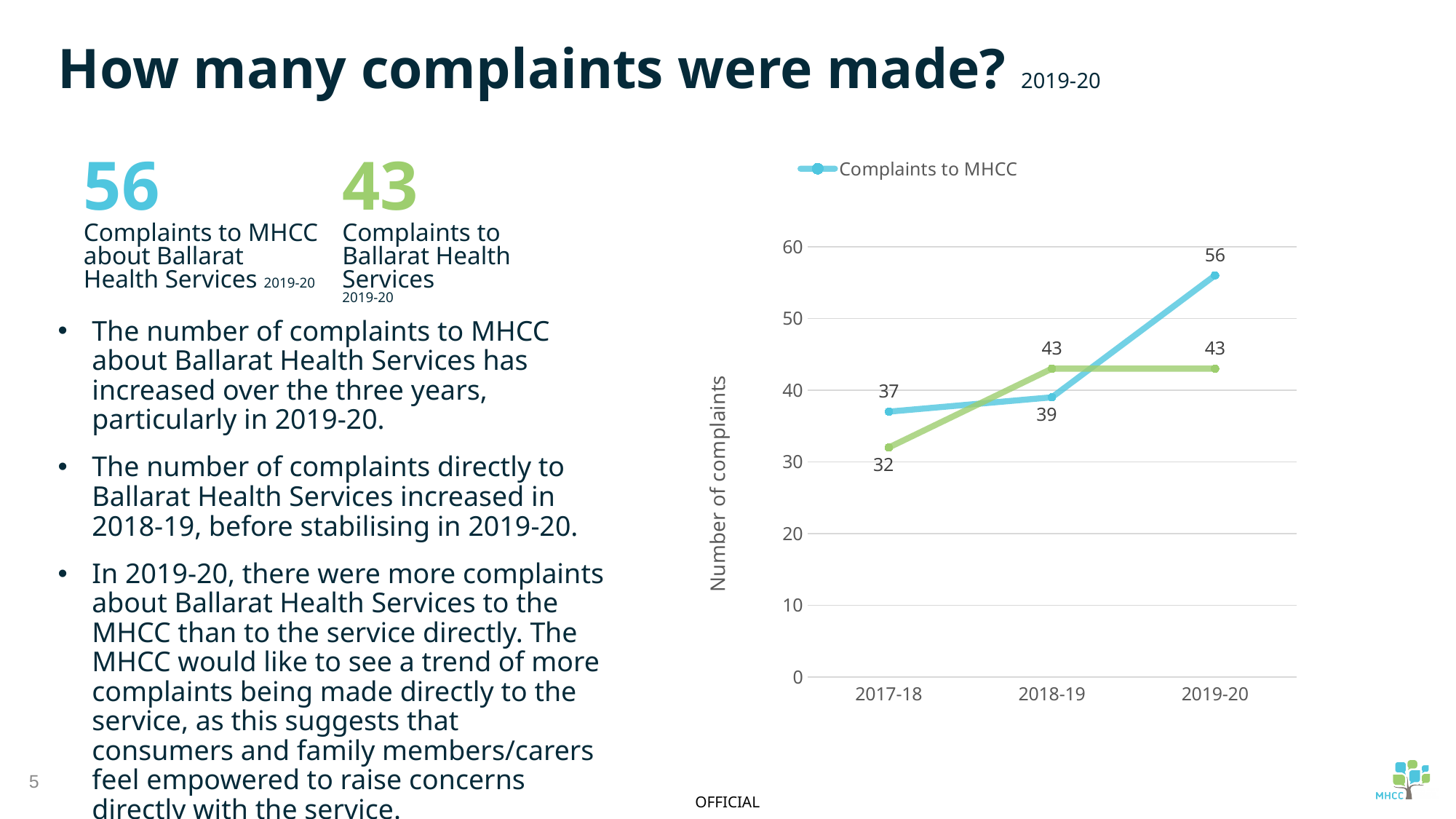
What is the value of the green line in 2018-19? 43 What is the value for Complaints to MHCC in 2018-19? 39 What is the value of the green line in 2017-18? 32 What kind of chart is shown on the slide? line chart How many years are shown on the x axis? 3 In 2018-19, which is larger: Complaints to MHCC or the green line? the green line What is the difference between Complaints to MHCC in 2019-20 and in 2018-19? 17 In which year is the value for Complaints to MHCC highest? 2019-20 What is the value for Complaints to MHCC in 2019-20? 56 Do the values for Complaints to MHCC rise or fall from 2017-18 to 2019-20? rise What is the value for Complaints to MHCC in 2017-18? 37 In which year is the value of the green line lowest? 2017-18